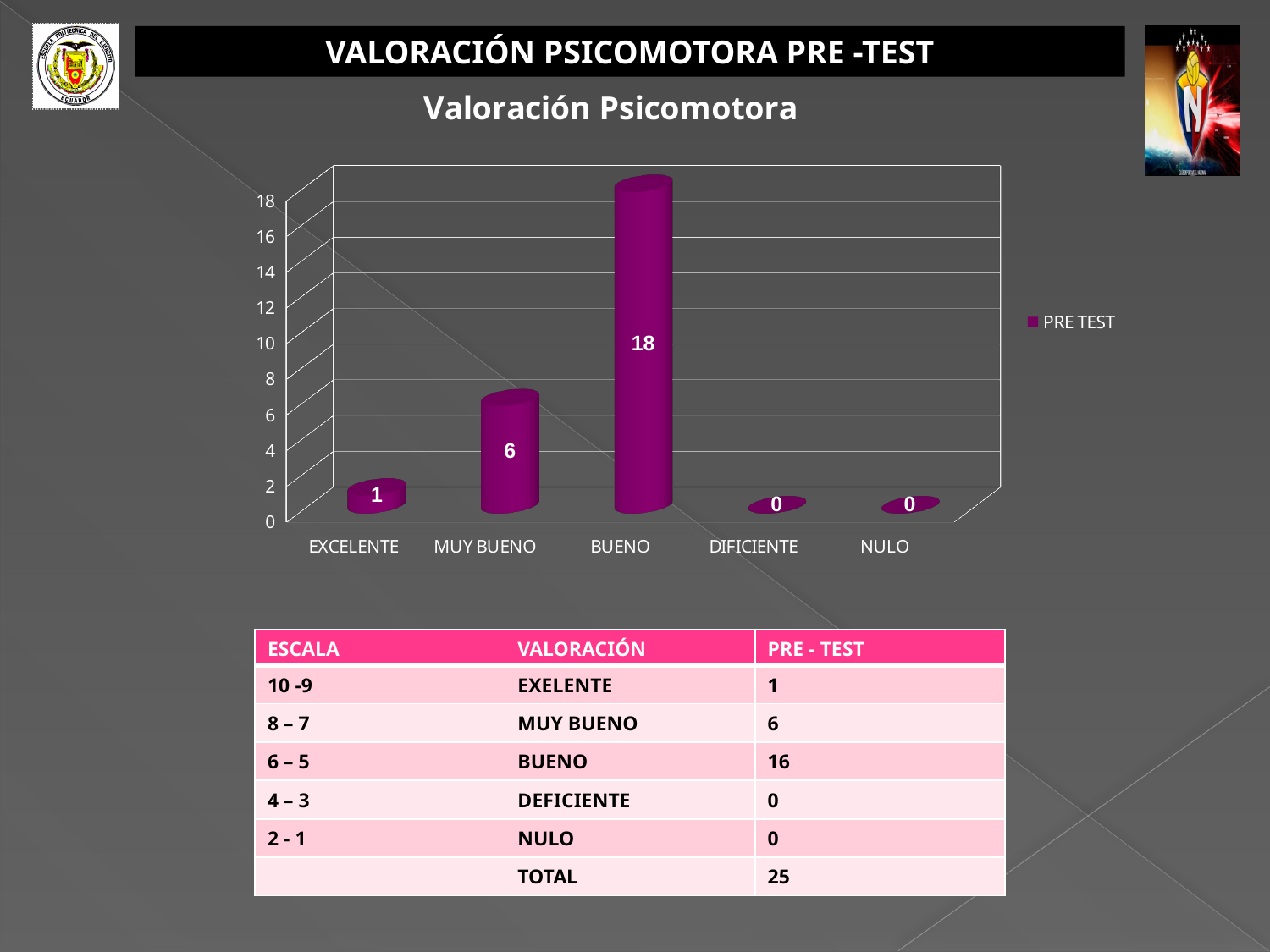
How many series does the chart legend list? 1 What is the value for EXCELENTE in the chart? 1 What is the value for DIFICIENTE in the chart? 0 What is the value for MUY BUENO in the chart? 6 What is the name of the series shown in the chart legend? PRE TEST What is the value for BUENO in the chart? 18 Which category has the highest value in the chart? BUENO What is the difference between the values for BUENO and MUY BUENO in the chart? 12 How many categories are shown on the x axis of the chart? 5 Is the value for BUENO in the chart greater or less than 10? greater Which is larger in the chart, the value for MUY BUENO or the value for EXCELENTE? MUY BUENO What kind of chart is shown on the slide? Bar chart